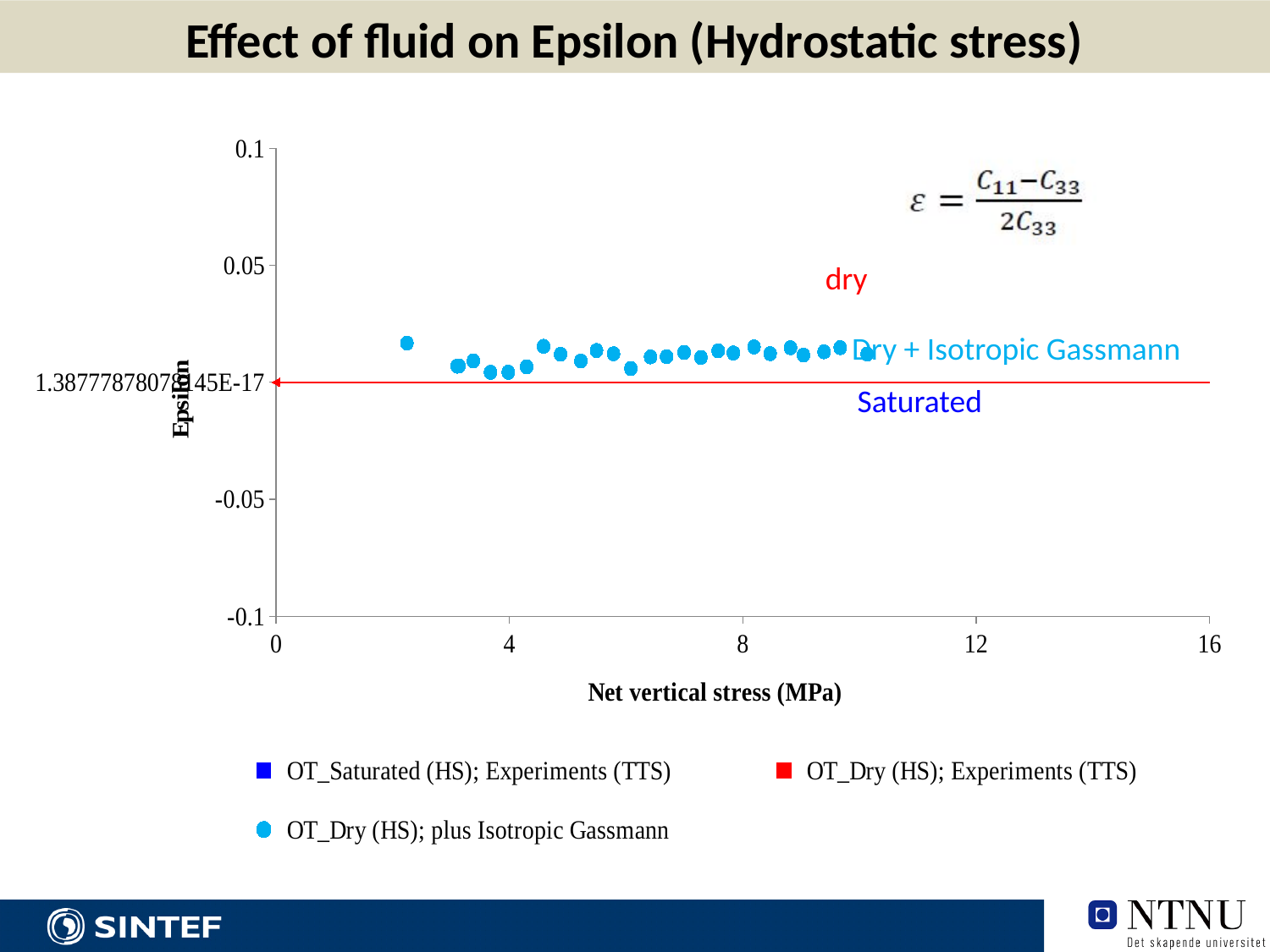
What is the maximum value shown on the y axis? 0.1 What is the label of the x axis? Net vertical stress (MPa) What is the title of the chart on the slide? Effect of fluid on Epsilon (Hydrostatic stress) Which series is drawn as light blue circular markers? OT_Dry (HS); plus Isotropic Gassmann How many series does the legend list? 3 Do the OT_Dry (HS); plus Isotropic Gassmann points lie above or below the red horizontal line? above What is the minimum value shown on the y axis? -0.1 Are the OT_Dry (HS); plus Isotropic Gassmann points plotted at net vertical stress values greater or less than 12 MPa? less Are the values of the OT_Dry (HS); plus Isotropic Gassmann series greater or less than -0.05? greater Are the values of the OT_Dry (HS); plus Isotropic Gassmann series greater or less than 0.05? less What kind of chart is shown on the slide? scatter chart What is the maximum value shown on the x axis? 16